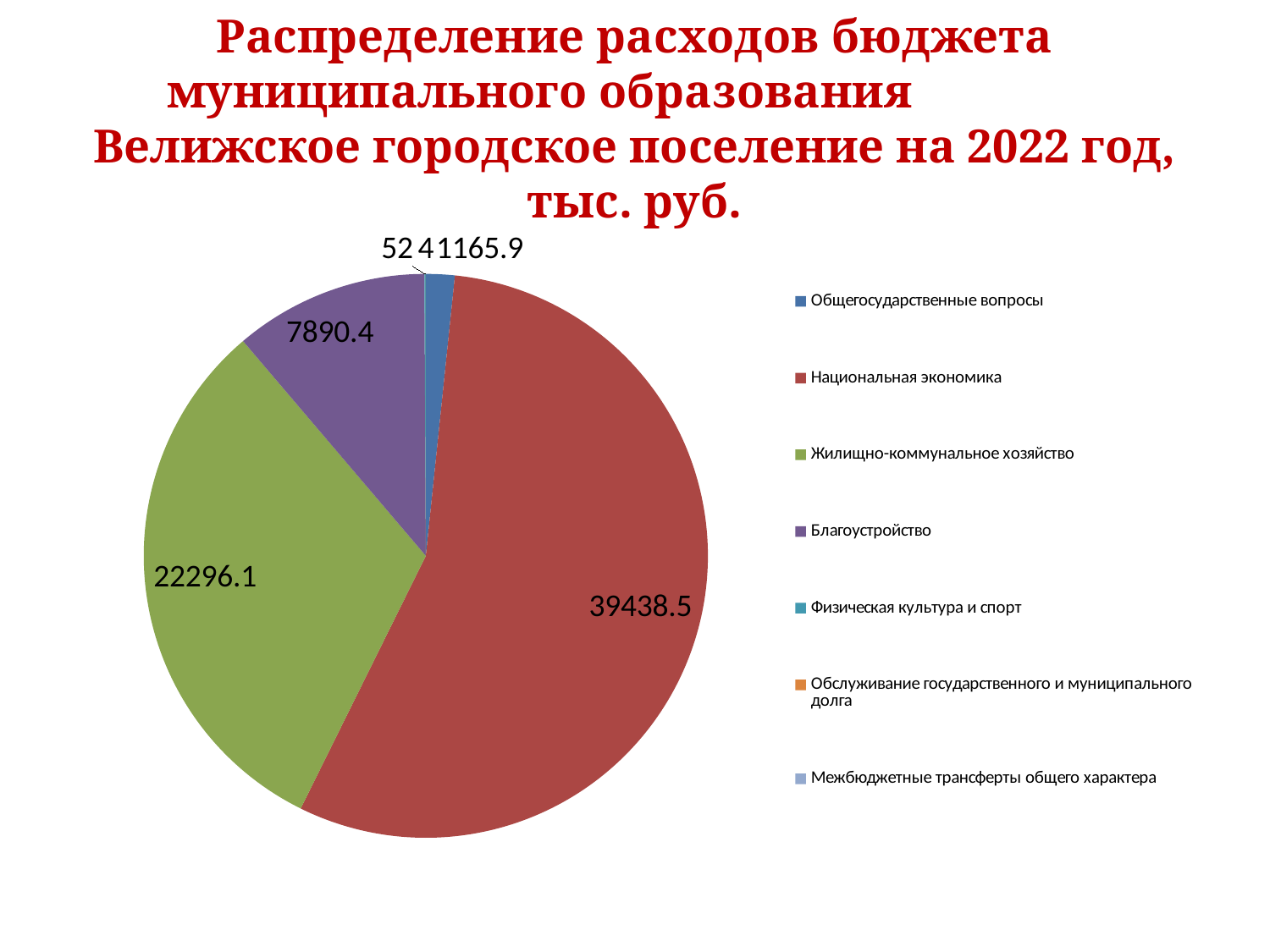
What is the difference between the values for Жилищно-коммунальное хозяйство and Благоустройство? 14405.7 What is the difference between the values for Национальная экономика and Жилищно-коммунальное хозяйство? 17142.4 What is the value for Благоустройство? 7890.4 Which category has the largest slice of the pie? Национальная экономика What colour is the slice for Национальная экономика? red What is the value for Национальная экономика? 39438.5 How many entries does the legend of the pie chart list? 7 For which year does the chart title say the budget expenditures are distributed? 2022 Which is larger, Национальная экономика or Жилищно-коммунальное хозяйство? Национальная экономика Which is larger, Жилищно-коммунальное хозяйство or Благоустройство? Жилищно-коммунальное хозяйство What is the value for Жилищно-коммунальное хозяйство? 22296.1 What kind of chart is shown on the slide? pie chart